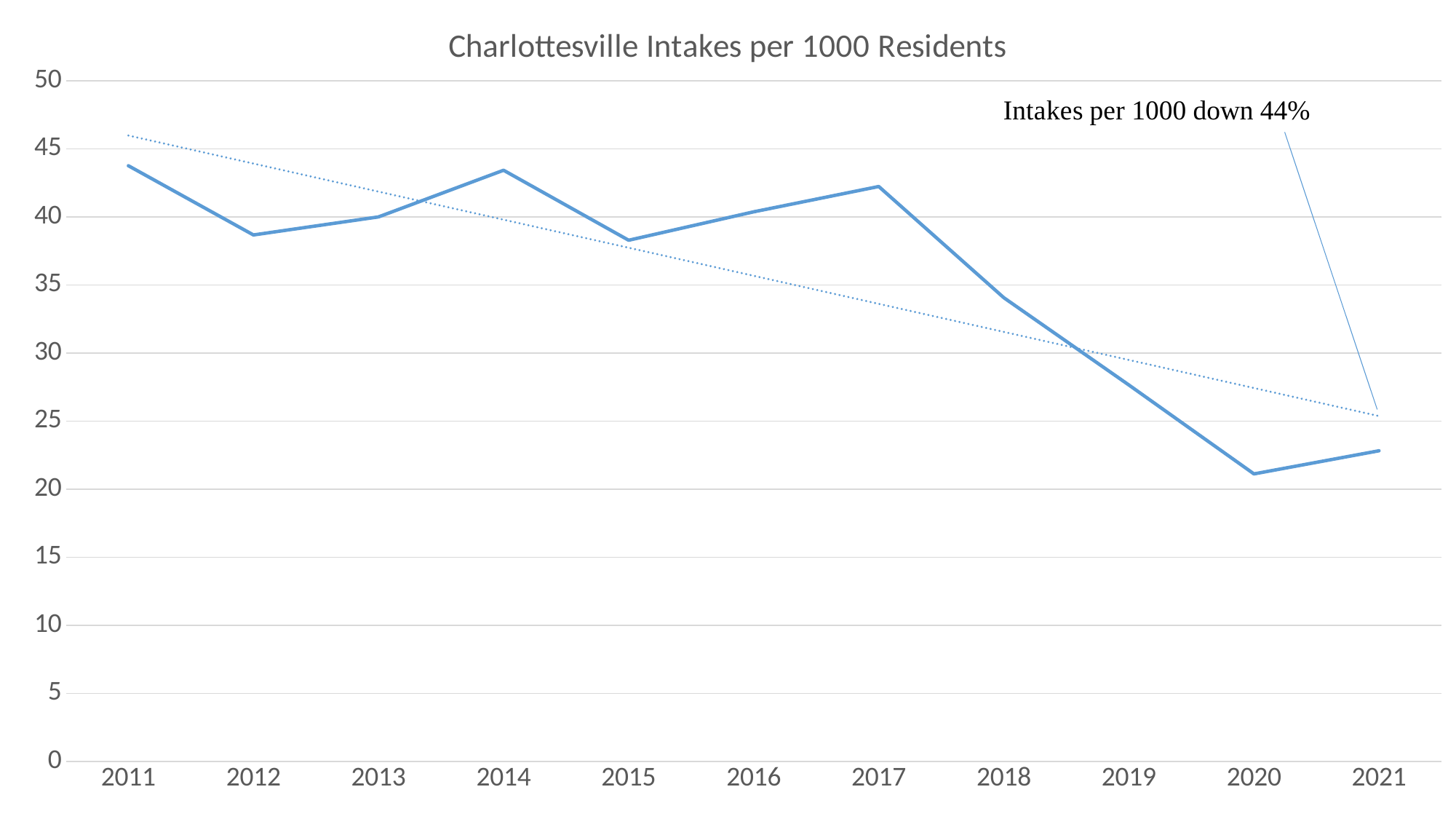
Is the value for 2018 greater or less than 30? greater How many years are plotted along the x axis? 11 Overall, do intakes per 1000 residents rise or fall from 2011 to 2021? fall Is the value for 2015 greater or less than 40? less Is the value for 2020 greater or less than 25? less Which year has the lowest intakes per 1000 residents? 2020 What does the text annotation on the chart say? Intakes per 1000 down 44% What kind of chart is shown on the slide? line chart What is the title of the chart? Charlottesville Intakes per 1000 Residents Which year has the higher value, 2017 or 2018? 2017